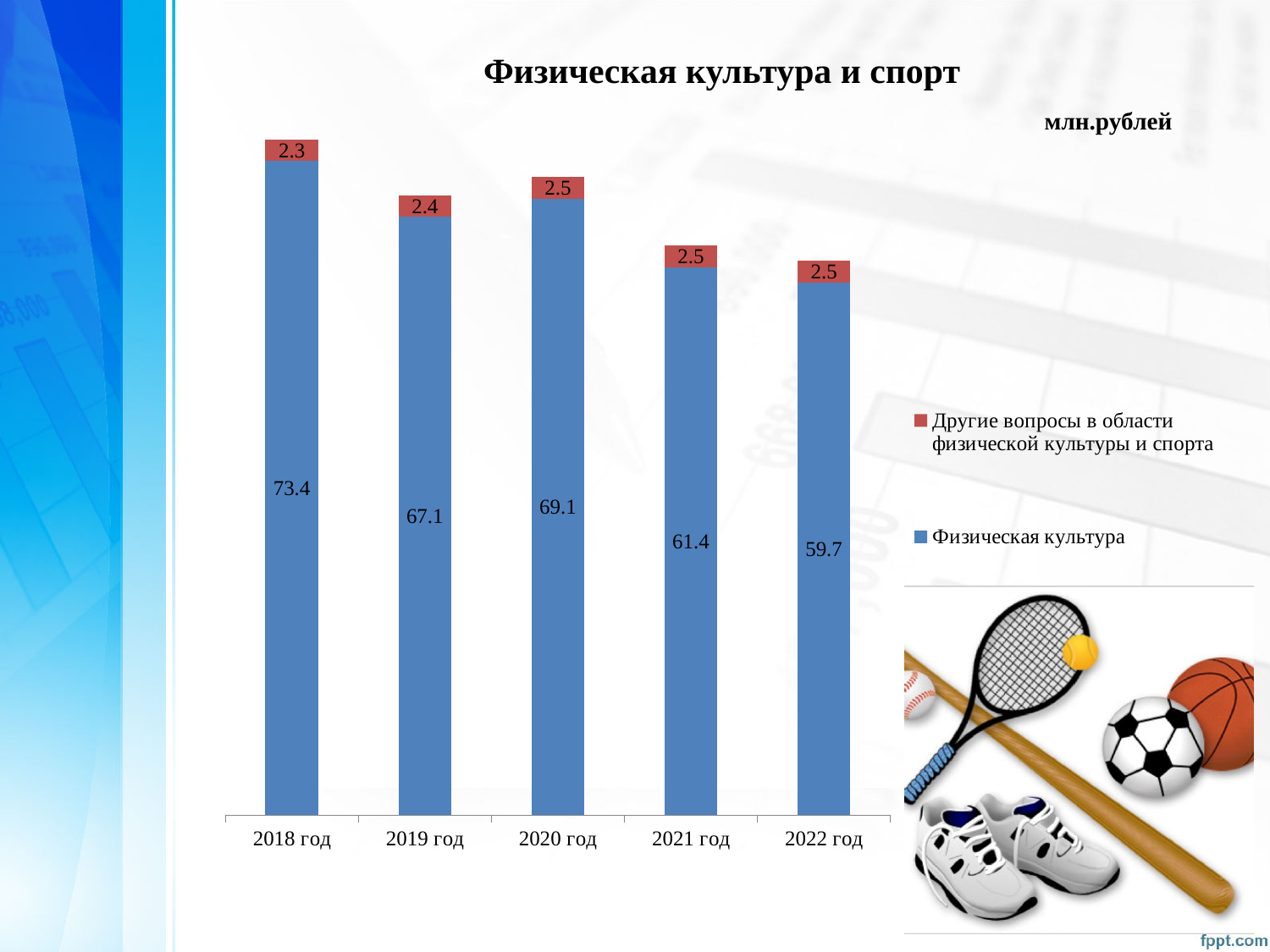
What kind of chart is shown on the slide? Stacked bar chart What is the value for Физическая культура in 2022 год? 59.7 What is the value for Другие вопросы в области физической культуры и спорта in 2019 год? 2.4 What is the total of the stacked bar for 2021 год? 63.9 Which year has the lowest value for Физическая культура? 2022 год Which year has the highest value for Физическая культура? 2018 год How many years are shown on the x axis? 5 Which is larger, the Физическая культура value for 2019 год or for 2020 год? 2020 год What unit is stated above the chart? млн.рублей How many series does the legend list? 2 What is the difference between the Физическая культура values for 2018 год and 2022 год? 13.7 What is the value for Физическая культура in 2018 год? 73.4